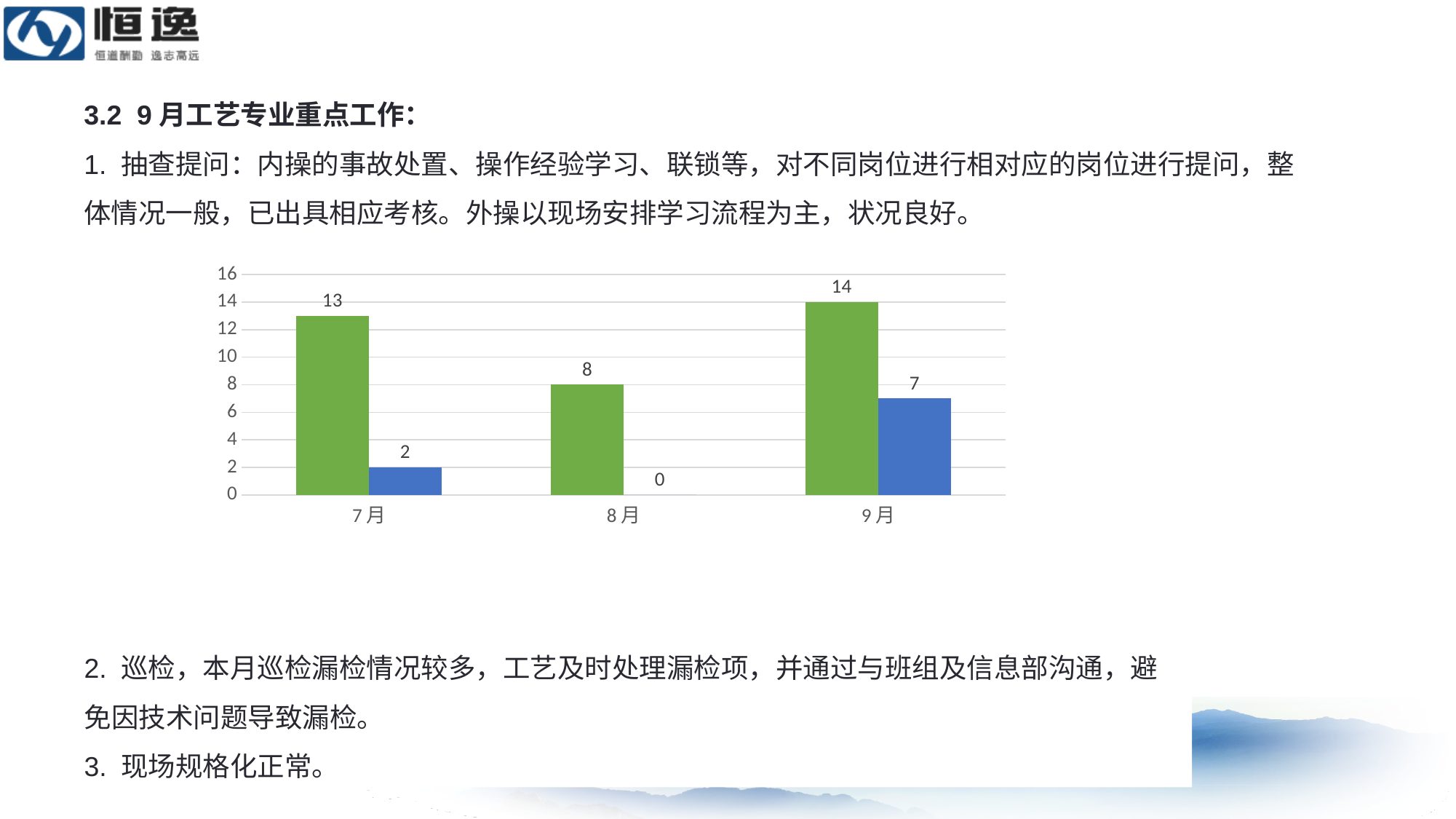
What is the value of the green bar for 8月? 8 How many months are shown on the x axis of the chart? 3 What is the value of the blue bar for 8月? 0 What is the difference between the green bar values for 9月 and 8月? 6 Do the blue bar values rise or fall from 8月 to 9月? rise Which is larger, the green bar for 7月 or the green bar for 9月? 9月 Which month has the highest green bar? 9月 What is the difference between the green bar and the blue bar for 7月? 11 What kind of chart is shown on the slide? bar chart Which month has the lowest blue bar? 8月 What is the value of the green bar for 7月? 13 What is the value of the blue bar for 9月? 7